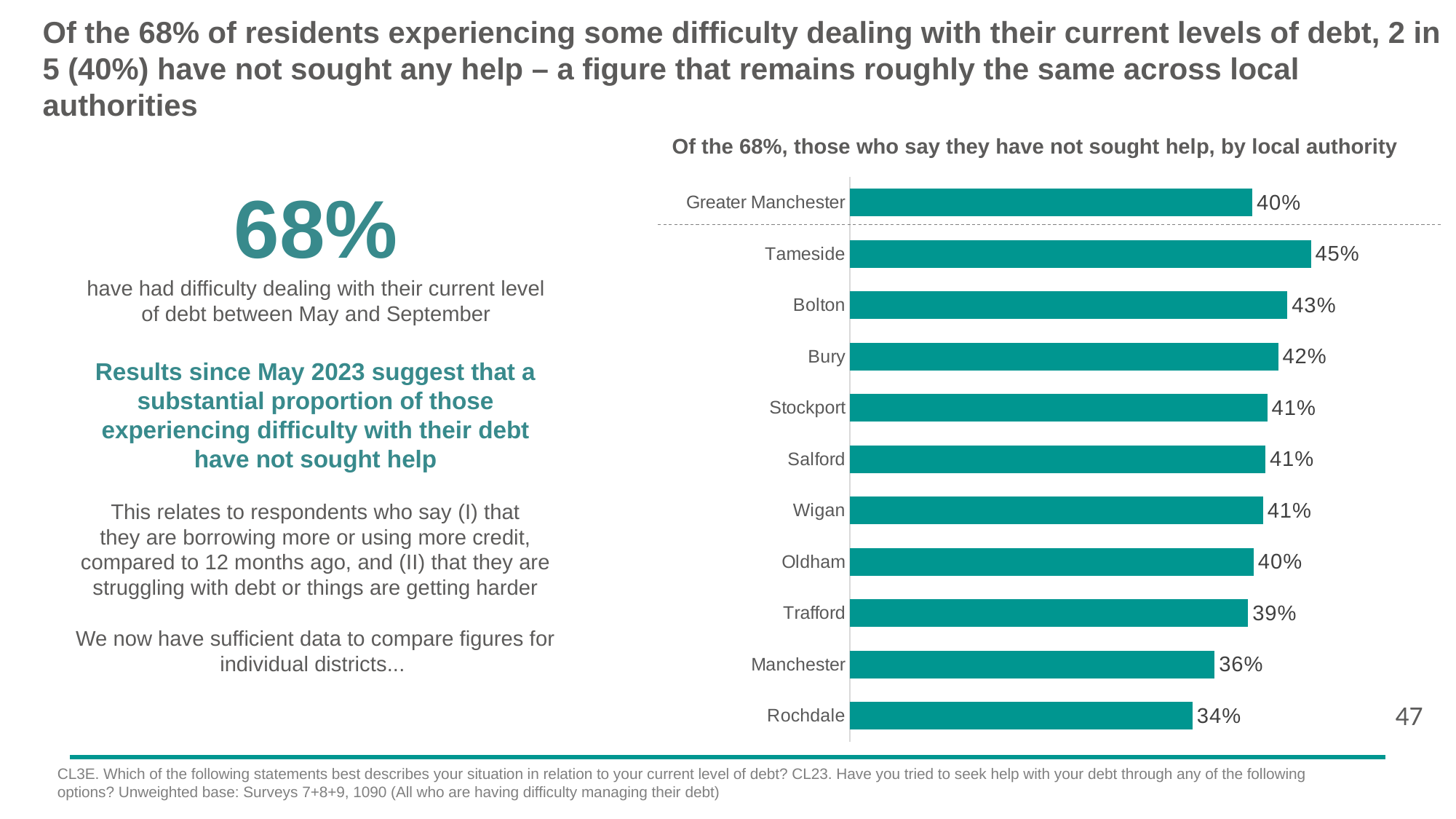
What is the value for Manchester? 36% Which local authority has the lowest value? Rochdale What is the value for Rochdale? 34% What is the value for Tameside? 45% Which has a larger value, Bury or Trafford? Bury Which local authority has the highest value? Tameside How many local authorities (bars) are shown in the chart? 11 What is the value for Greater Manchester? 40% What is the difference between the values for Bolton and Manchester? 7% What kind of chart is shown on the slide? Bar chart What is the title of the chart? Of the 68%, those who say they have not sought help, by local authority What is the difference between the values for Tameside and Rochdale? 11%